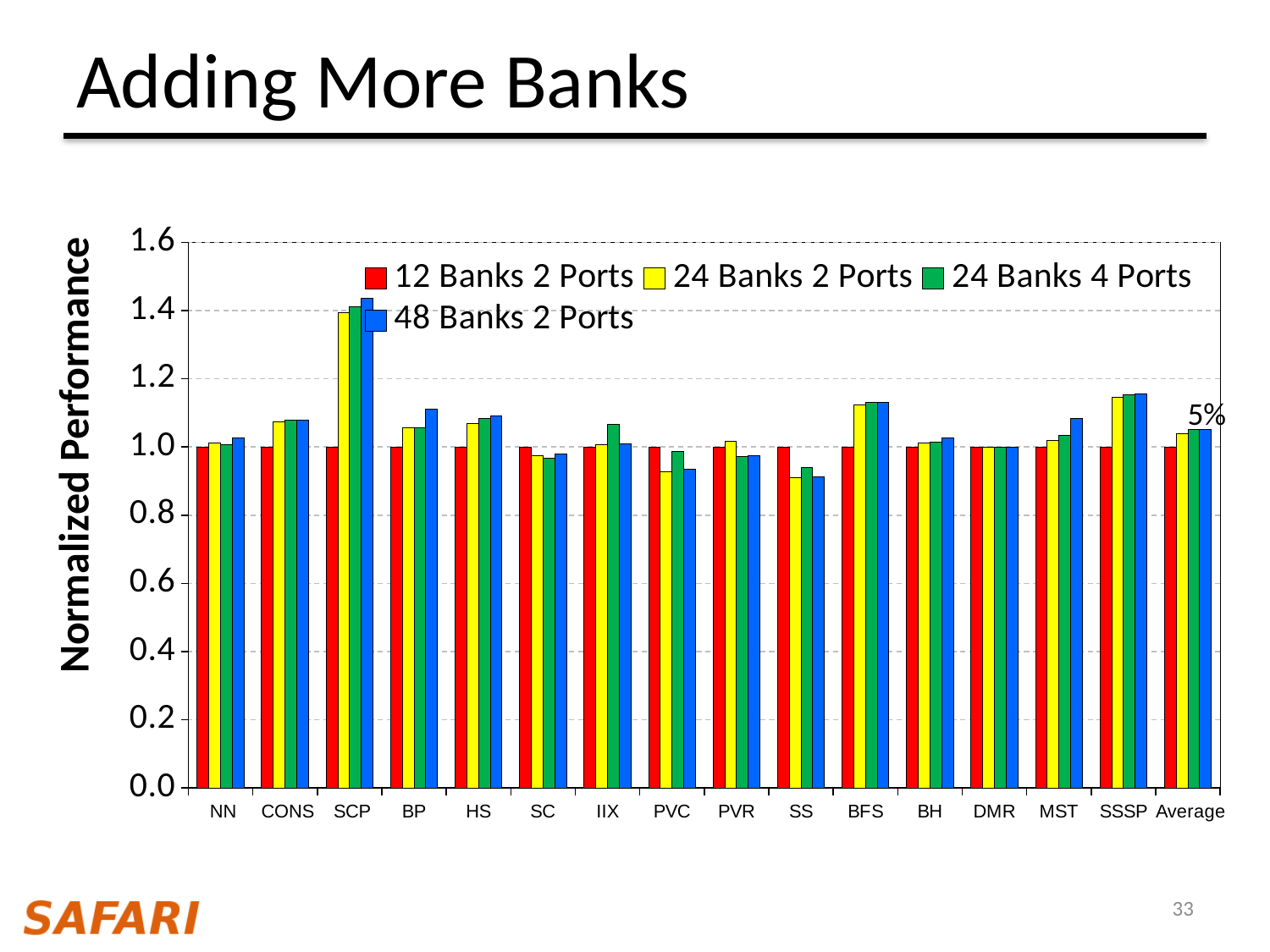
What percentage label is printed above the Average bars? 5% How many categories are shown along the x axis? 16 Which category has the highest value for 48 Banks 2 Ports? SCP Is the value for IIX in the 24 Banks 4 Ports series greater or less than 1.0? greater What is the y-axis title of the chart? Normalized Performance How many series does the legend list? 4 Is the value for SCP in the 24 Banks 2 Ports series greater or less than 1.2? greater What kind of chart is shown on the slide? bar chart Is the value for SS in the 24 Banks 2 Ports series greater or less than 1.0? less For SCP, which is larger: the 48 Banks 2 Ports bar or the 24 Banks 2 Ports bar? 48 Banks 2 Ports What is the value for NN in the 12 Banks 2 Ports series? 1.0 Which is larger for 48 Banks 2 Ports: BFS or SS? BFS